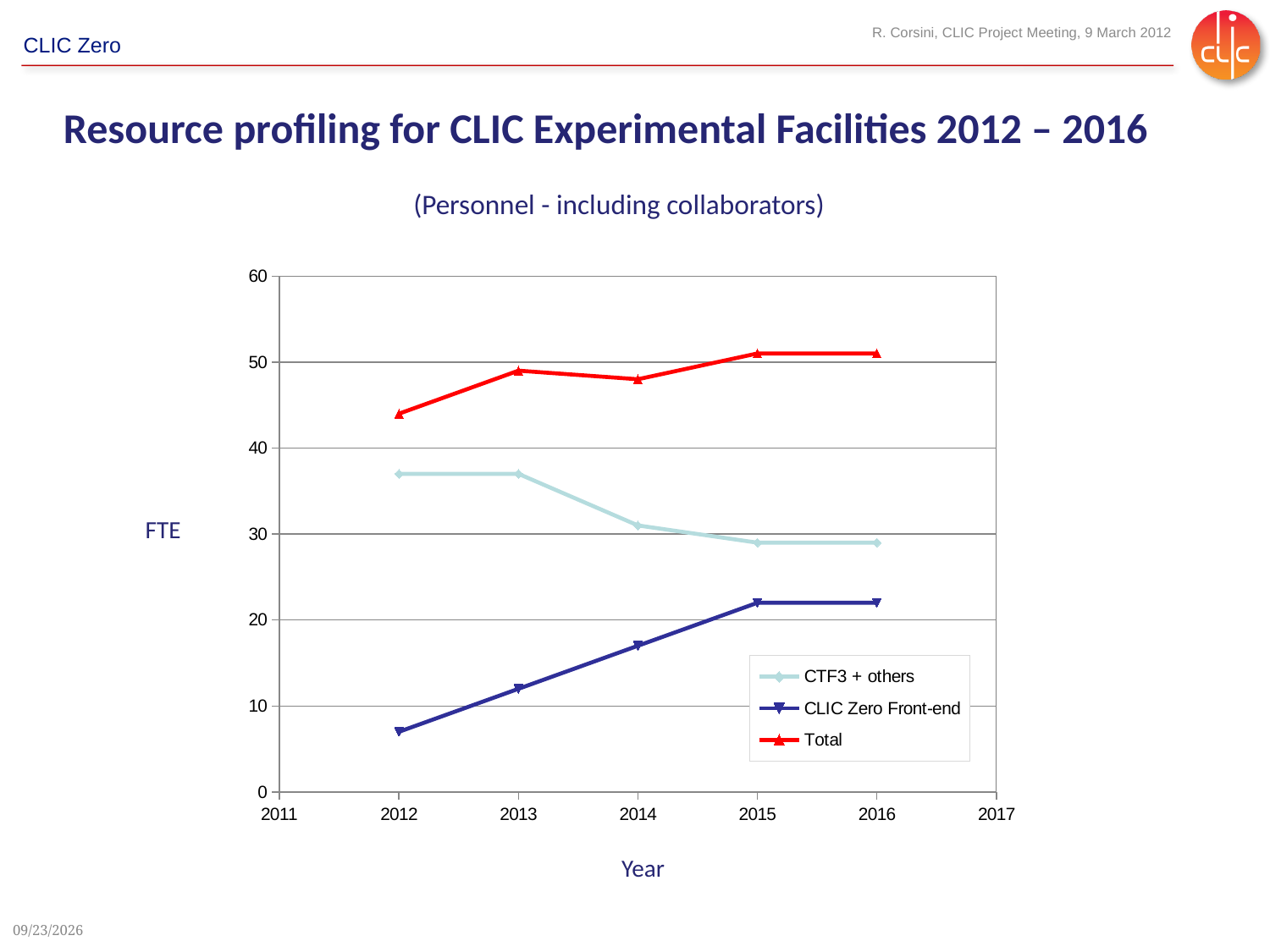
Does the CLIC Zero Front-end series rise or fall from 2012 to 2016? rise What is the label on the y axis of the chart? FTE Is the value for CLIC Zero Front-end in 2012 greater or less than 10? less In 2016, which is larger: CTF3 + others or CLIC Zero Front-end? CTF3 + others How many years have data points plotted for the Total series? 5 Which series has the highest value in 2016? Total Is the value for CTF3 + others in 2012 greater or less than 40? less How many series does the legend list? 3 What kind of chart is shown on the slide? line chart Is the value for Total in 2012 greater or less than 40? greater Which series has the lowest value in 2012? CLIC Zero Front-end Does the CTF3 + others series rise or fall from 2012 to 2016? fall